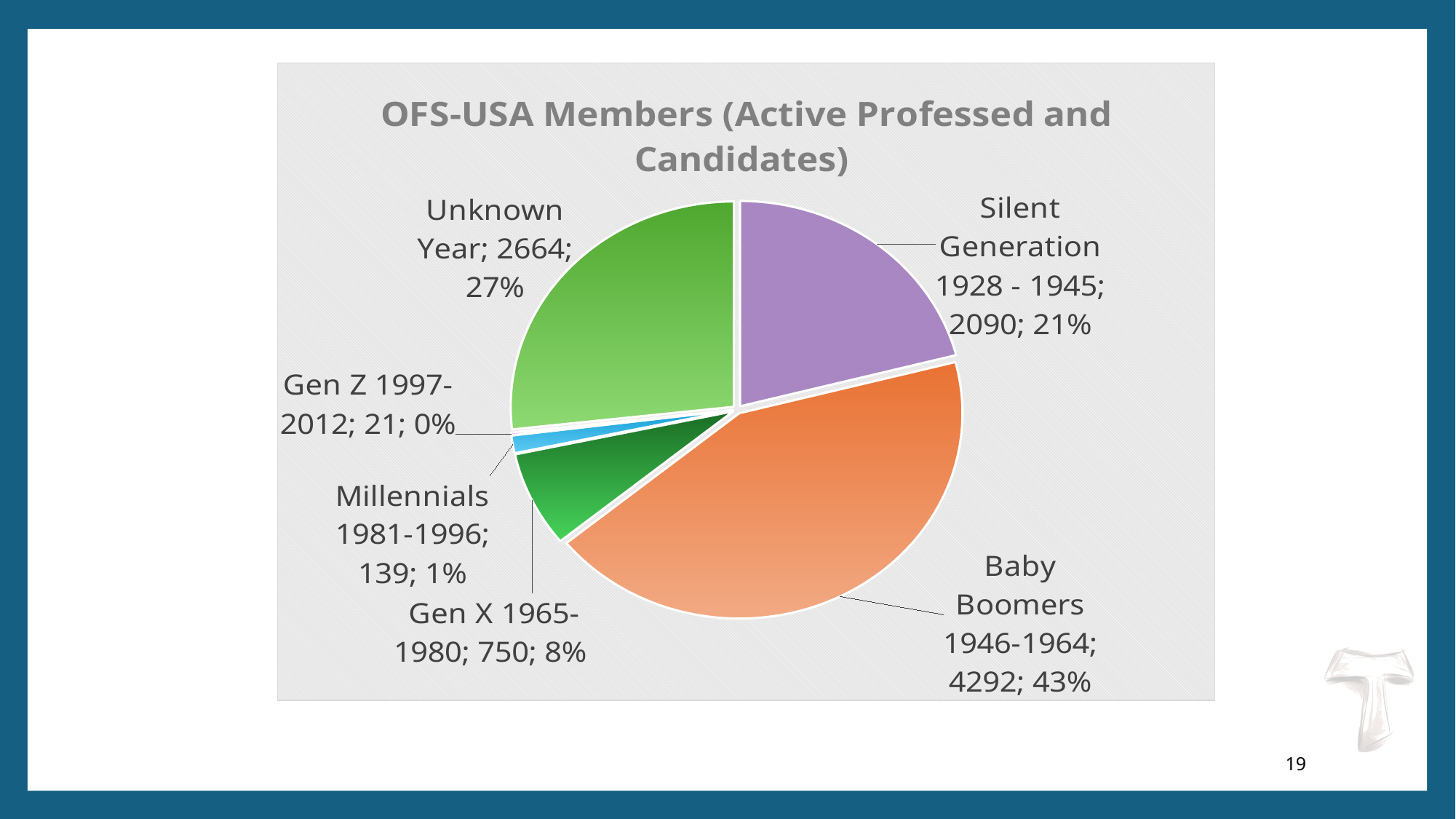
What percentage share does the Unknown Year slice represent? 27% Which is larger, the value for Millennials 1981-1996 or the value for Gen X 1965-1980? Gen X 1965-1980 Which category has the smallest slice? Gen Z 1997-2012 What is the value for Gen X 1965-1980? 750 What is the title of the chart? OFS-USA Members (Active Professed and Candidates) What percentage share does the Silent Generation 1928 - 1945 slice represent? 21% What type of chart is shown on the slide? pie chart What colour is the Baby Boomers 1946-1964 slice? orange How many members are in the Baby Boomers 1946-1964 category? 4292 Which category has the largest slice? Baby Boomers 1946-1964 How many slices does the pie chart have? 6 What is the difference between the Unknown Year value and the Silent Generation 1928 - 1945 value? 574